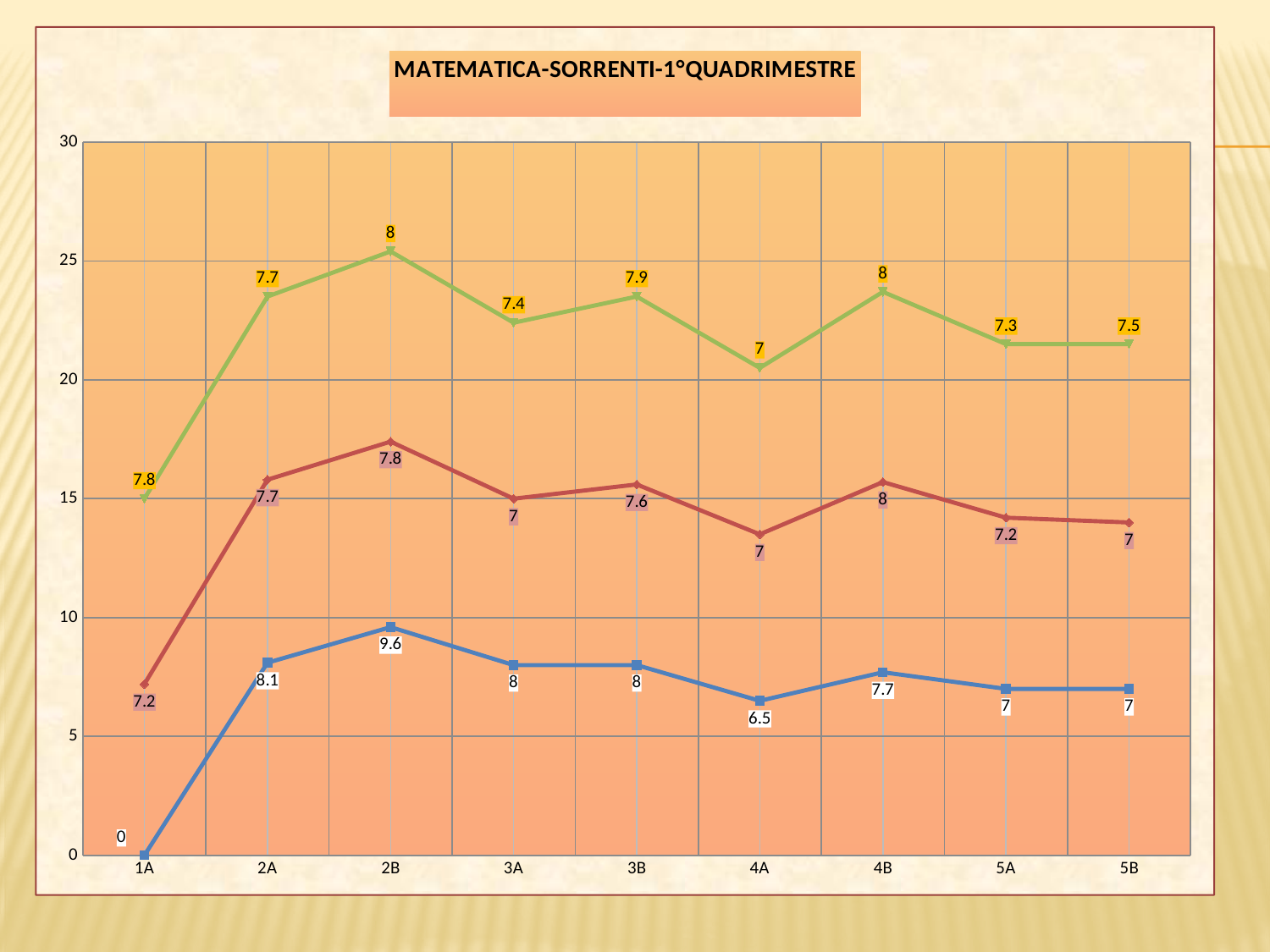
What is the value labelled on the blue line for 2B? 9.6 For which category does the blue line have its highest labelled value? 2B What is the title of the chart? MATEMATICA-SORRENTI-1°QUADRIMESTRE What is the value labelled on the red line for 4B? 8 What is the difference between the blue line's values for 2B and 4A? 3.1 What type of chart is shown on the slide? line chart Which has the larger value on the blue line, 2A or 5A? 2A For which category does the blue line have its lowest labelled value? 1A Does the blue line rise or fall from 2B to 4A? fall For which category does the green line have its lowest labelled value? 4A What is the value labelled on the green line for 3B? 7.9 How many categories are shown on the x axis? 9